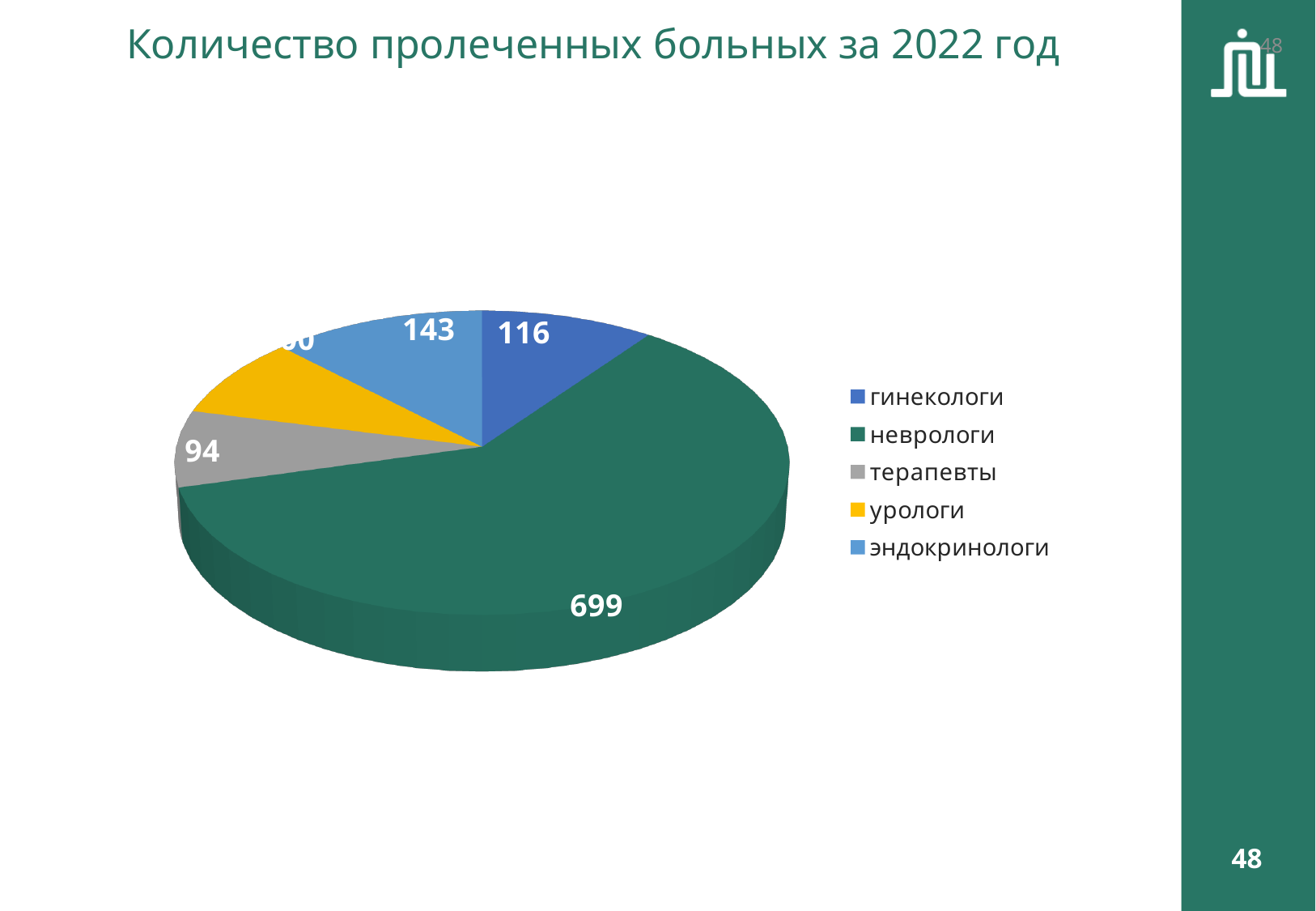
What is the difference between the values for эндокринологи and гинекологи? 27 How many categories does the pie chart show? 5 What value is shown for эндокринологи on the pie chart? 143 What is the title of the chart on the slide? Количество пролеченных больных за 2022 год What value is shown for гинекологи on the pie chart? 116 What type of chart is shown on the slide? pie chart What value is shown for терапевты on the pie chart? 94 What is the difference between the values for гинекологи and терапевты? 22 By how much does the value for неврологи exceed the value for эндокринологи? 556 How many patients were treated by неврологи according to the pie chart? 699 Which is larger: the value for гинекологи or the value for эндокринологи? эндокринологи Which category has the largest slice of the pie chart? неврологи